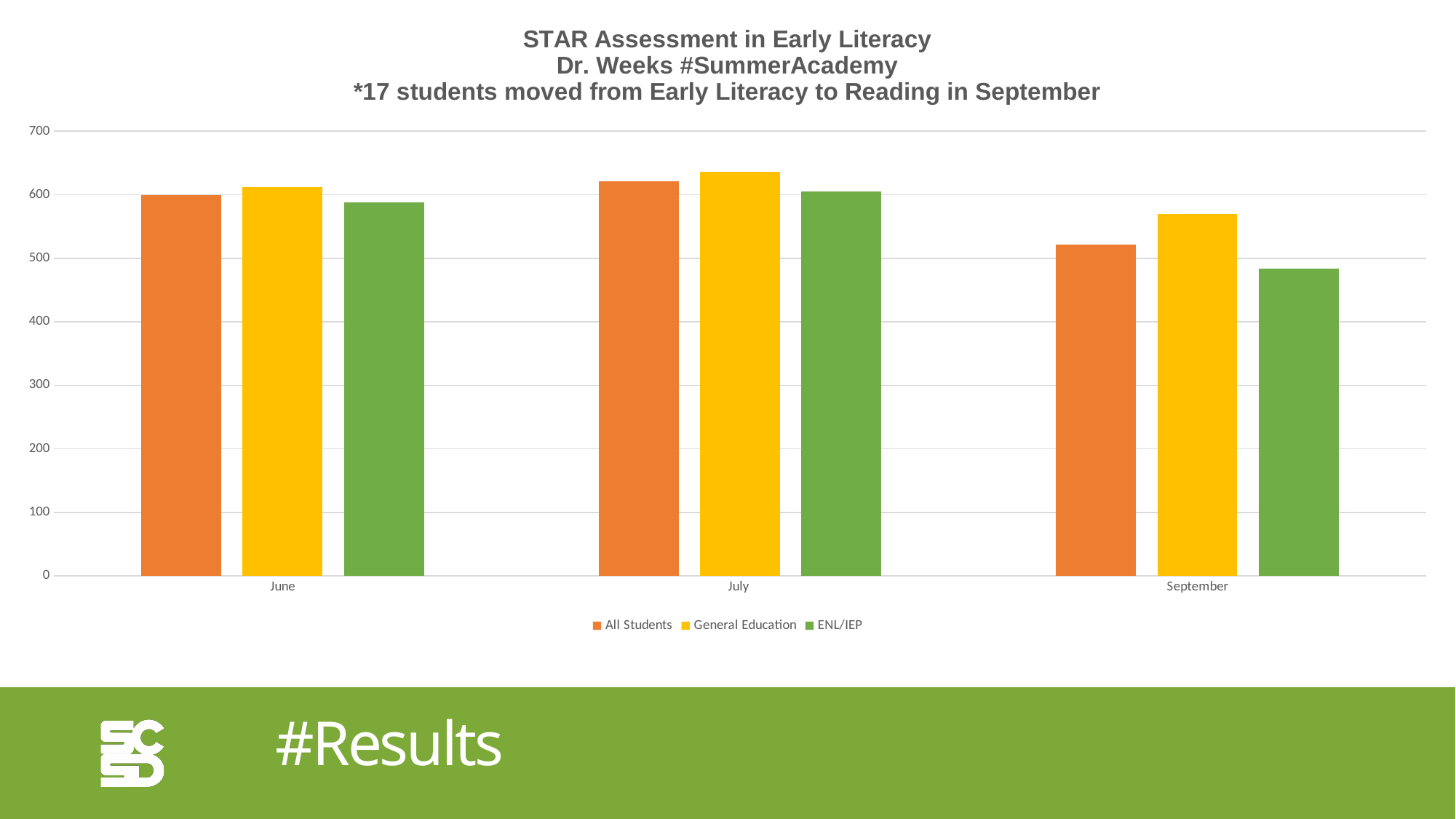
Which month has the lowest ENL/IEP bar? September Is the value for General Education in July greater or less than 600? greater Which series has the highest bar in September? General Education Is the value for General Education in September greater or less than 600? less How many series does the legend list? 3 What kind of chart is shown on the slide? bar chart Is the value for ENL/IEP in September greater or less than 500? less Which series is shown in green in the legend? ENL/IEP How many categories are shown on the x axis? 3 Which is larger, the All Students value in July or the All Students value in September? July Which month has the highest General Education bar? July Which series has the lowest bar in September? ENL/IEP